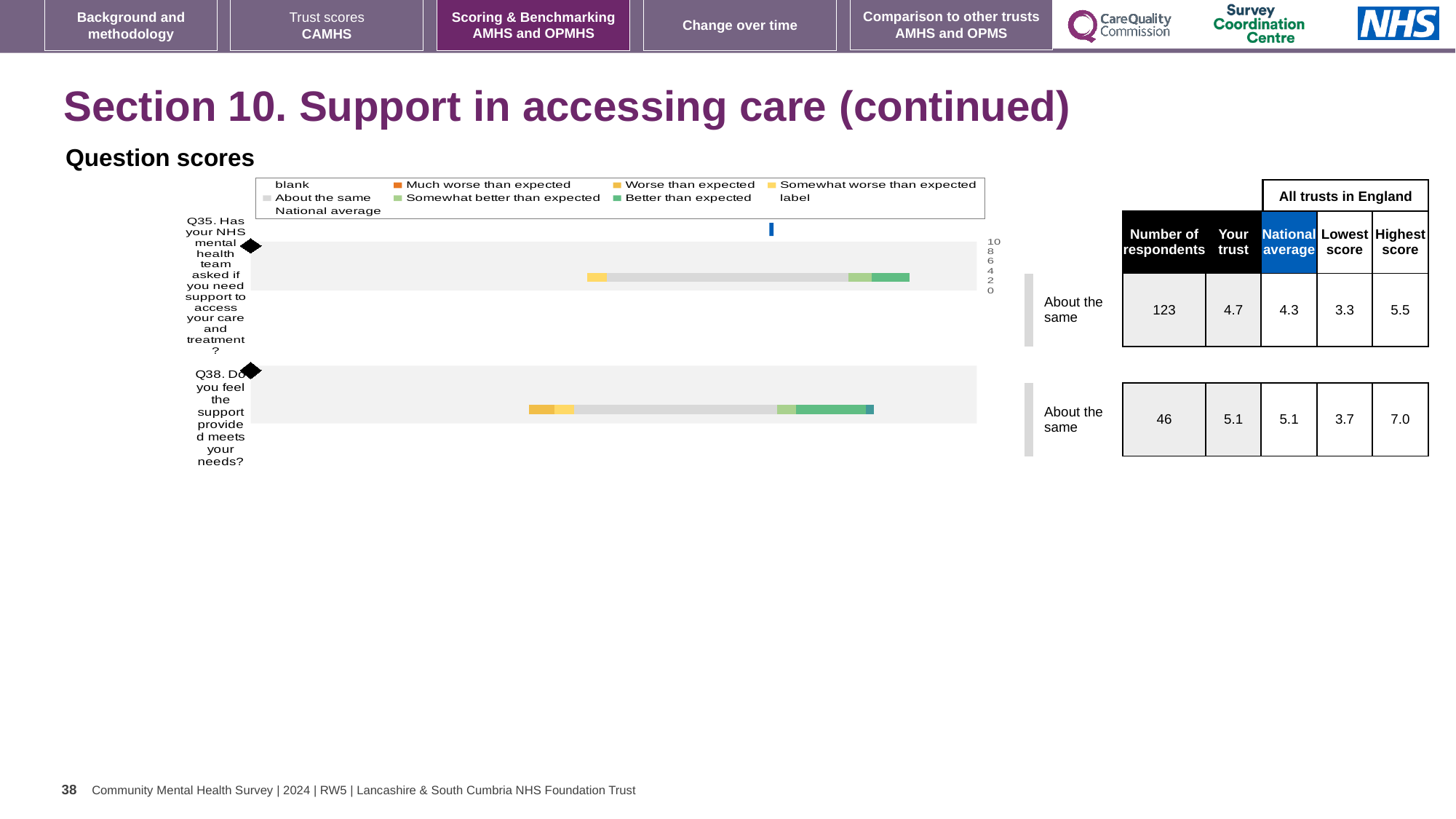
How many entries does the legend of the question scores chart list? 9 What is the national average score for Q38 (Do you feel the support provided meets your needs?)? 5.1 Which question has the higher 'Your trust' score, Q35 or Q38? Q38 In the question scores chart legend, what colour represents 'Better than expected'? green Which benchmark category is Q38 placed in? About the same How many respondents answered Q35? 123 For Q35, which is larger: the 'Your trust' score or the national average? Your trust What is the difference between the highest score and the lowest score for Q35? 2.2 In the question scores chart legend, what colour represents 'Much worse than expected'? orange What kind of chart is used to show the question scores for Q35 and Q38? bar chart What is the 'Your trust' score for Q35 (Has your NHS mental health team asked if you need support to access your care and treatment?)? 4.7 How many questions are plotted in the question scores chart? 2